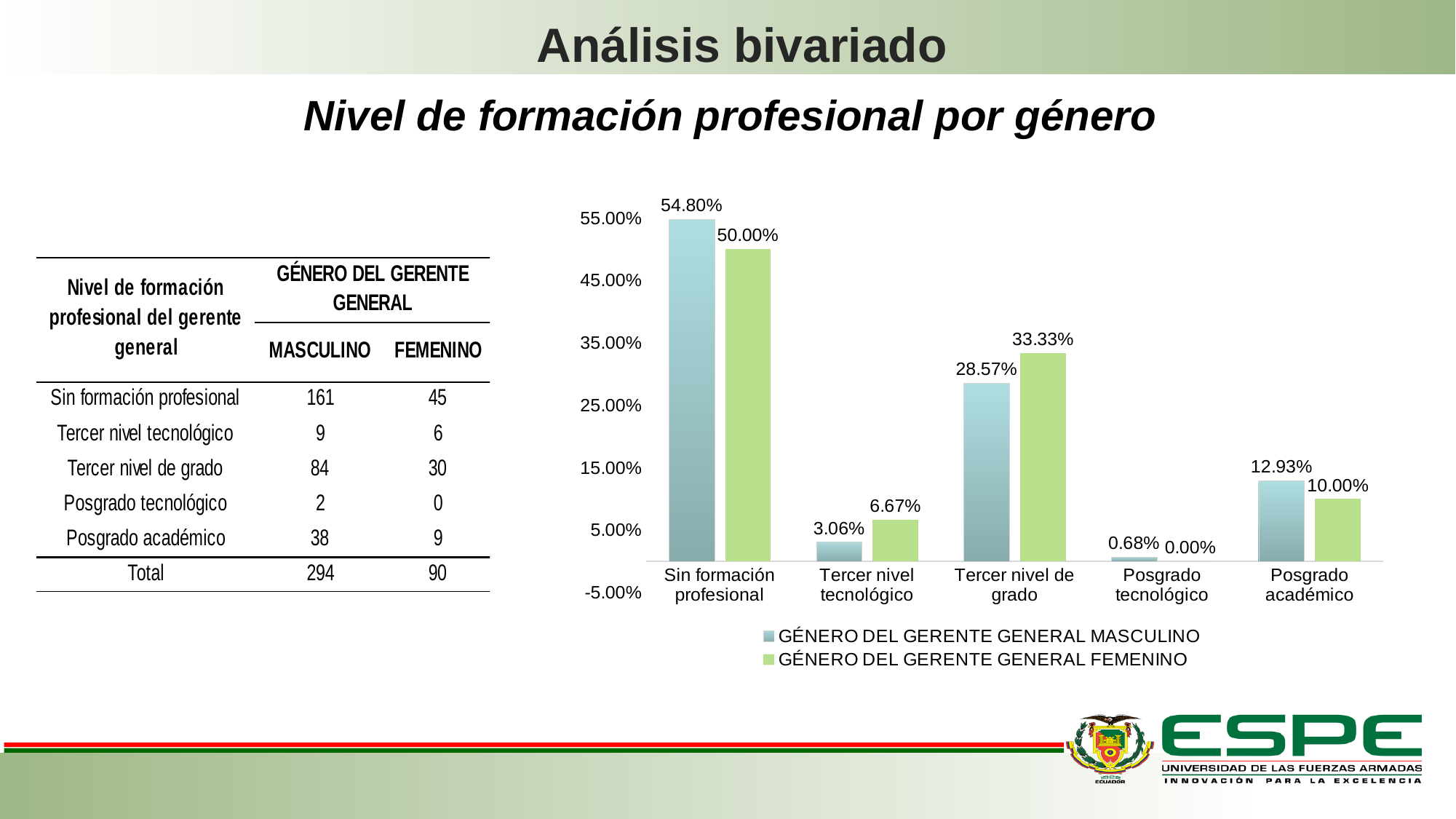
Is the FEMENINO value for 'Tercer nivel de grado' greater or less than 25.00%? greater What kind of chart is shown on the slide? Bar chart What is the value for MASCULINO in the 'Posgrado tecnológico' category? 0.68% Which category has the lowest value for the MASCULINO series? Posgrado tecnológico Which is larger for 'Posgrado académico': the MASCULINO value or the FEMENINO value? MASCULINO What is the difference between the FEMENINO and MASCULINO values for 'Tercer nivel tecnológico'? 3.61% What is the difference between the MASCULINO and FEMENINO values for 'Sin formación profesional'? 4.80% Which category has the highest value for the FEMENINO series? Sin formación profesional What is the value for MASCULINO in the 'Sin formación profesional' category? 54.80% What is the value for FEMENINO in the 'Tercer nivel de grado' category? 33.33% How many categories are shown on the x axis of the chart? 5 How many series does the chart legend list? 2